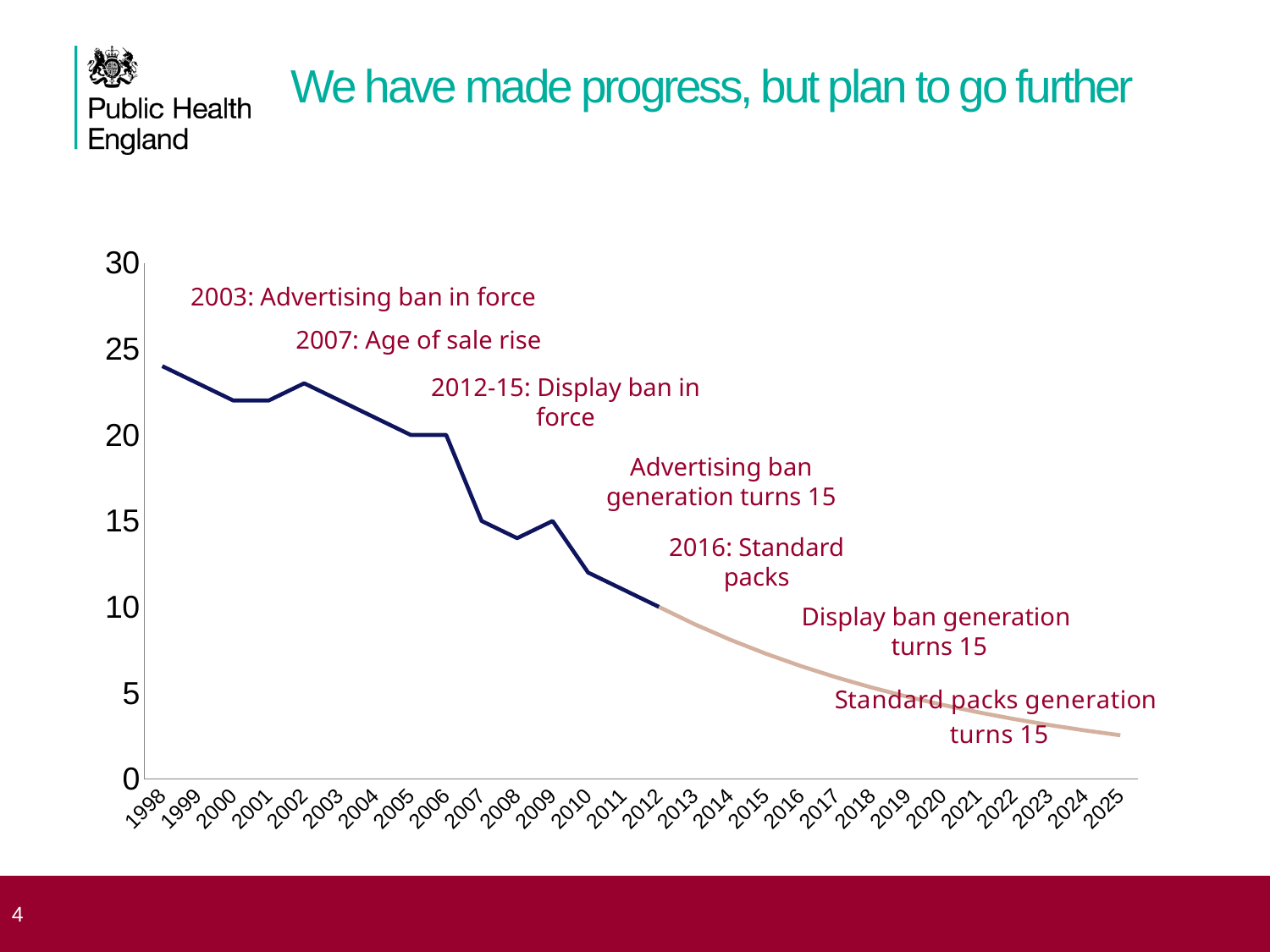
Is the value for 2008 greater or less than 15? less Do the values rise or fall from 1998 to 2025? fall Which year has the highest value on the chart? 1998 Which year has the lowest value on the chart? 2025 Is the value for 1998 greater or less than 20? greater Is the value for 2018 greater or less than 10? less According to the annotation on the chart, what happened in 2007? Age of sale rise What is the title of the slide? We have made progress, but plan to go further Which year has the larger value, 1998 or 2012? 1998 What kind of chart is shown on the slide? line chart How many years are labelled on the x axis? 28